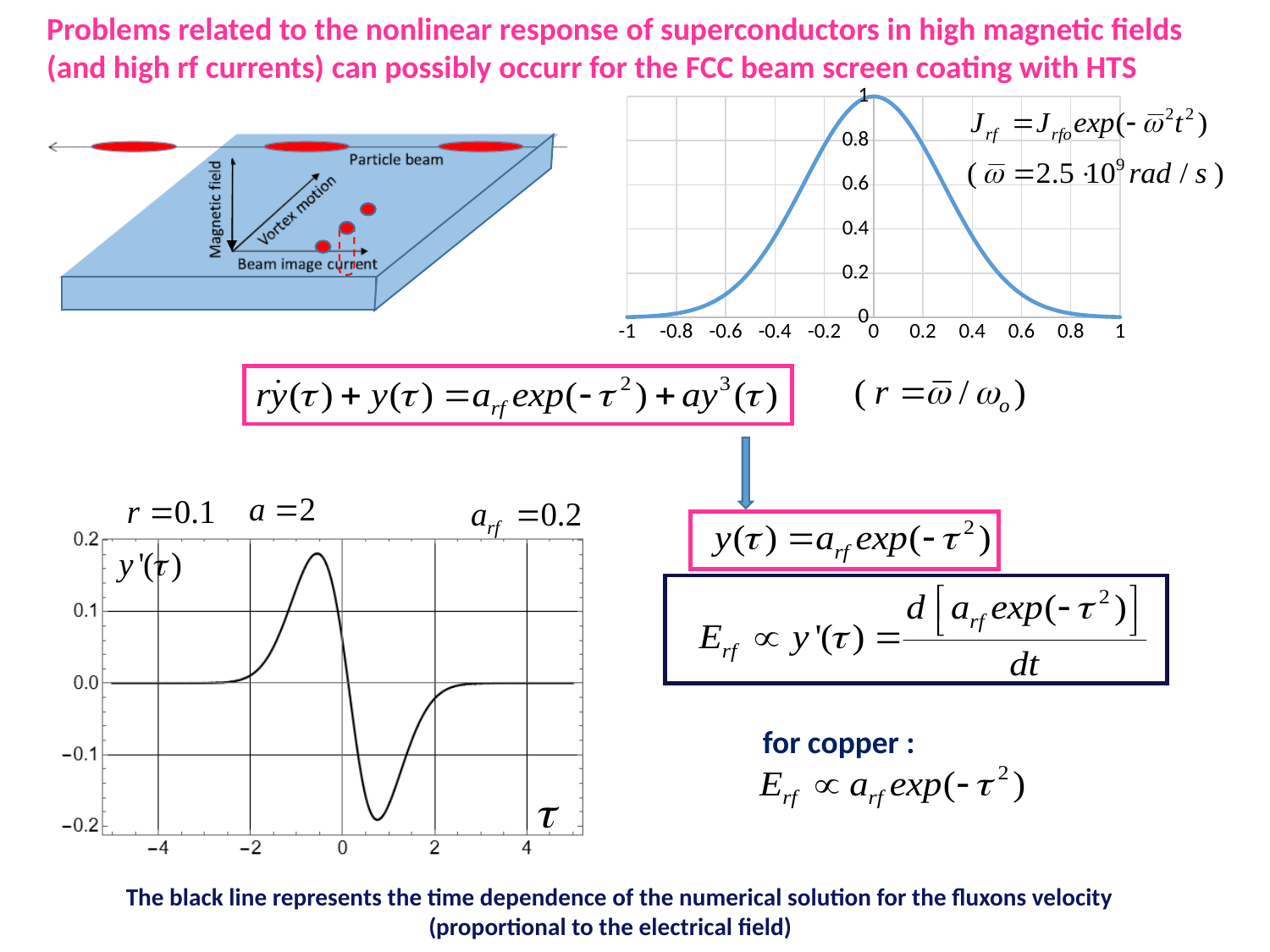
In the top-right chart, does the curve rise or fall as x goes from 0 to 1? fall In the bottom-left chart, what is the label on the x axis? τ In the bottom-left chart, is the value of the curve at τ = -0.5 greater or less than 0.1? greater In the top-right chart, does the curve rise or fall as x goes from -1 to 0? rise In the top-right chart, is the value of the curve at x = 0.8 greater or less than 0.2? less In the bottom-left chart, is the value of the curve at τ = 0.7 greater or less than -0.1? less In the bottom-left chart, does the curve rise or fall as τ goes from -0.5 to 0.5? fall In the top-right chart, what is the value of the curve at x = 0? 1 What kind of chart is the top-right chart on the slide? line chart What kind of chart is the bottom-left chart on the slide? line chart In the top-right chart, at which x value does the curve reach its maximum? 0